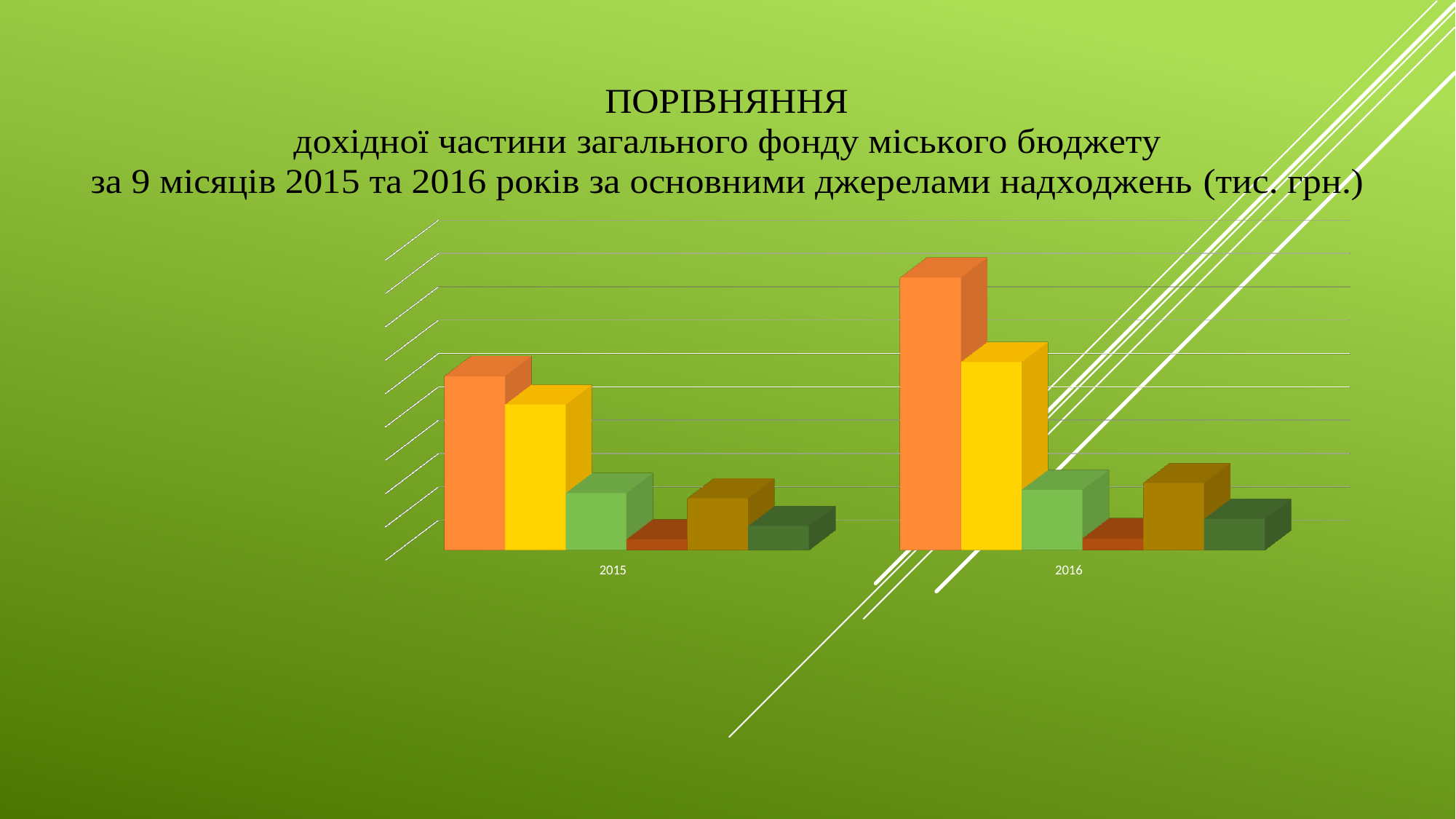
Is the orange bar taller in 2015 or in 2016? 2016 In the 2016 group, which is taller: the light green bar or the dark red bar? the light green bar How many categories are shown on the x axis of the chart? 2 According to the title, in what units are the values of the chart given? тис. грн. How many bars are plotted for each year category? 6 Which coloured bar is the tallest in the 2016 group? the orange bar What are the two categories labelled on the x axis? 2015 and 2016 Is the yellow bar taller in 2015 or in 2016? 2016 Does the orange bar rise or fall from 2015 to 2016? rises Which coloured bar is the shortest in the 2015 group? the dark red bar What kind of chart is shown on the slide? bar chart